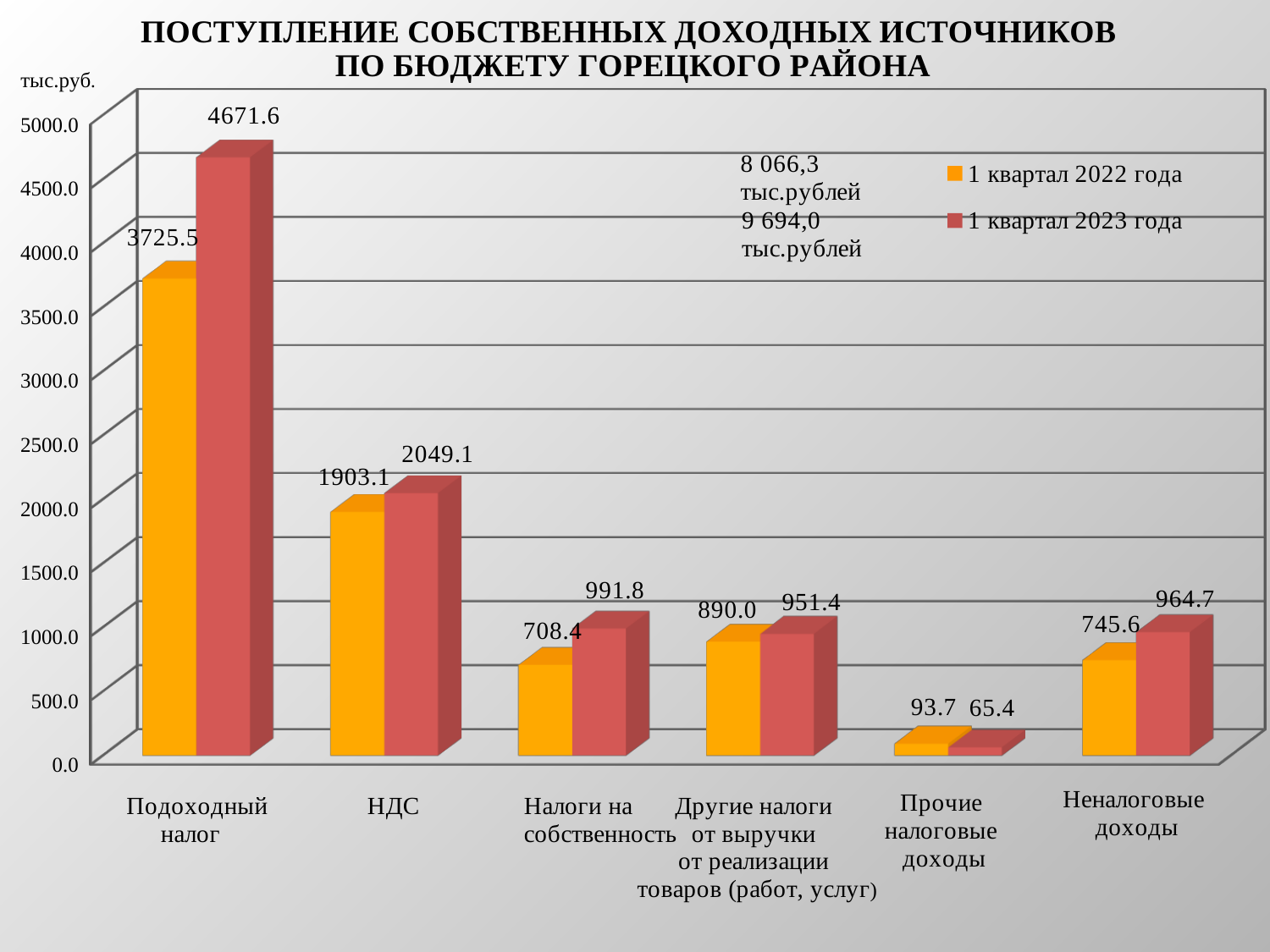
Which category has the highest value in 1 квартал 2022 года? Подоходный налог Which is larger for Прочие налоговые доходы: the value for 1 квартал 2022 года or 1 квартал 2023 года? 1 квартал 2022 года What is the value for НДС in 1 квартал 2022 года? 1903.1 Is the value for Налоги на собственность in 1 квартал 2022 года greater or less than 1000.0? less What is the value for Подоходный налог in 1 квартал 2023 года? 4671.6 What is the difference between the 1 квартал 2023 года and 1 квартал 2022 года values for Подоходный налог? 946.1 What unit is shown at the top of the vertical axis? тыс.руб. How many series does the legend list? 2 What is the value for Неналоговые доходы in 1 квартал 2023 года? 964.7 What kind of chart is shown on the slide? bar chart How many categories are shown on the x axis? 6 Which category has the lowest value in 1 квартал 2023 года? Прочие налоговые доходы